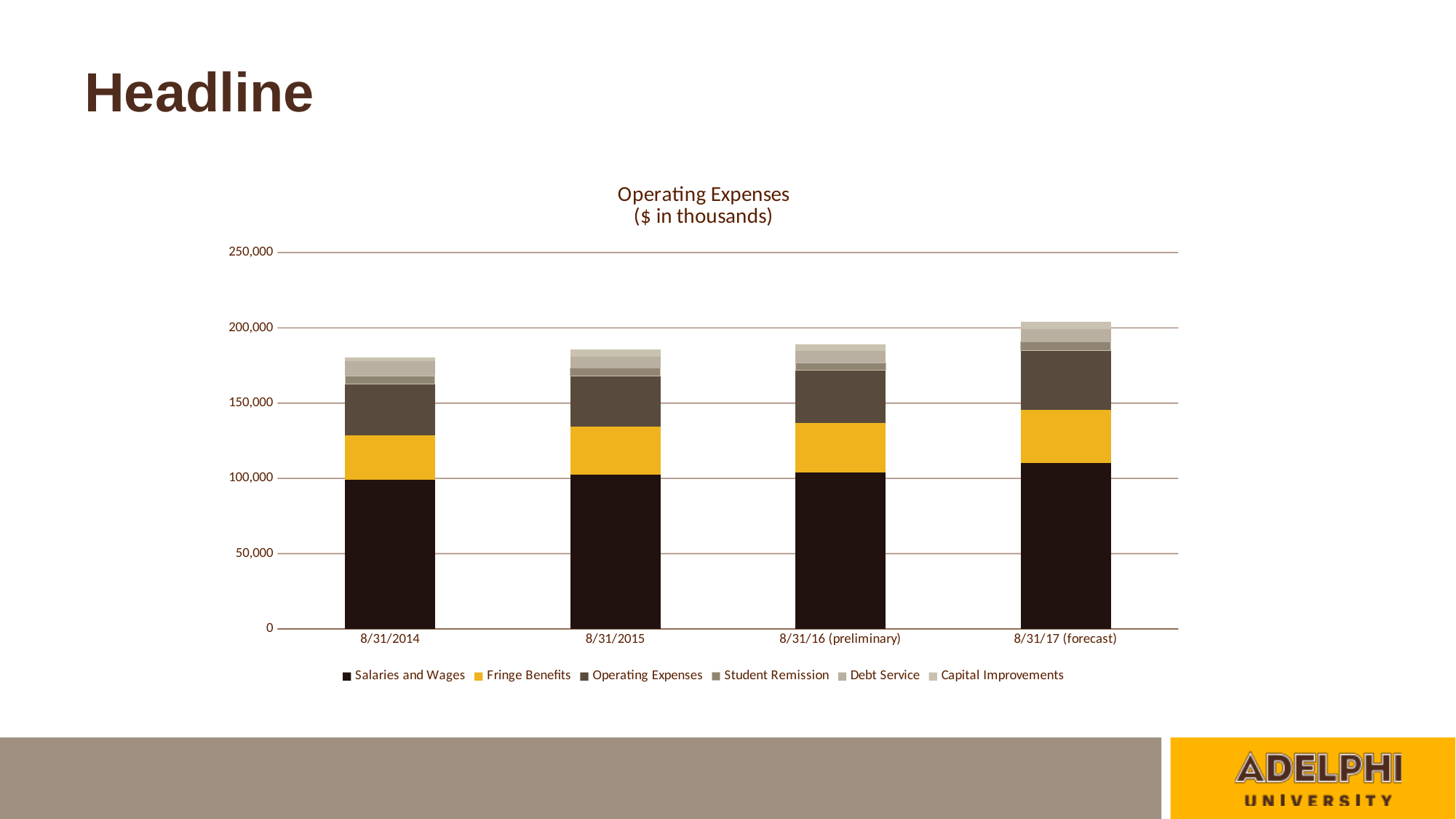
Which series is shown in yellow in the chart? Fringe Benefits Which date has the shortest total stacked bar? 8/31/2014 Is the total stacked bar for 8/31/17 (forecast) greater or less than 200,000? greater How many series does the chart's legend list? 6 Is the Salaries and Wages value for 8/31/17 (forecast) greater or less than 100,000? greater How many dates (categories) are shown on the x axis of the chart? 4 Is the total stacked bar for 8/31/2014 greater or less than 200,000? less Which date has the tallest total stacked bar? 8/31/17 (forecast) What kind of chart is shown on the slide? Stacked bar chart Do the total operating expenses rise or fall from 8/31/2014 to 8/31/17 (forecast)? Rise What is the title of the chart? Operating Expenses ($ in thousands) Which has the larger total stacked bar, 8/31/2015 or 8/31/17 (forecast)? 8/31/17 (forecast)